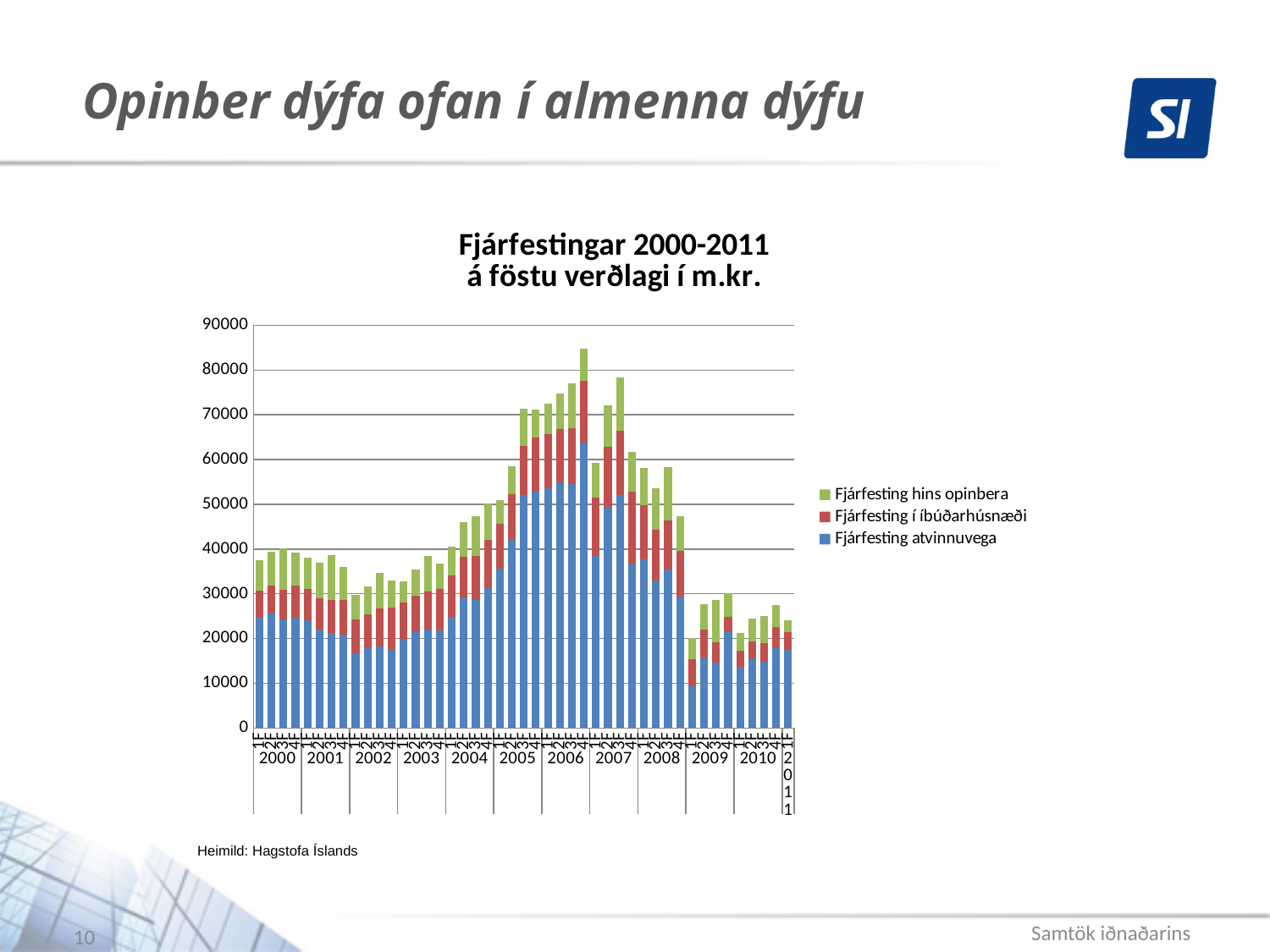
Is the total of the first bar of 2009 greater or less than 30000? less Which series is shown in green in the chart? Fjárfesting hins opinbera What is the title of the chart? Fjárfestingar 2000-2011 á föstu verðlagi í m.kr. Do the stacked bar totals rise or fall from 2008 to 2009? fall In which year does the tallest stacked bar in the chart occur? 2006 How many years are labelled along the x axis of the chart? 12 Are the stacked bar totals in 2009 higher or lower than those in 2007? lower Is the Fjárfesting atvinnuvega value for the first bar of 2000 greater or less than 20000? greater Is the total of the tallest bar in 2006 greater or less than 80000? greater What kind of chart is shown on the slide? Stacked bar chart How many series does the legend list? 3